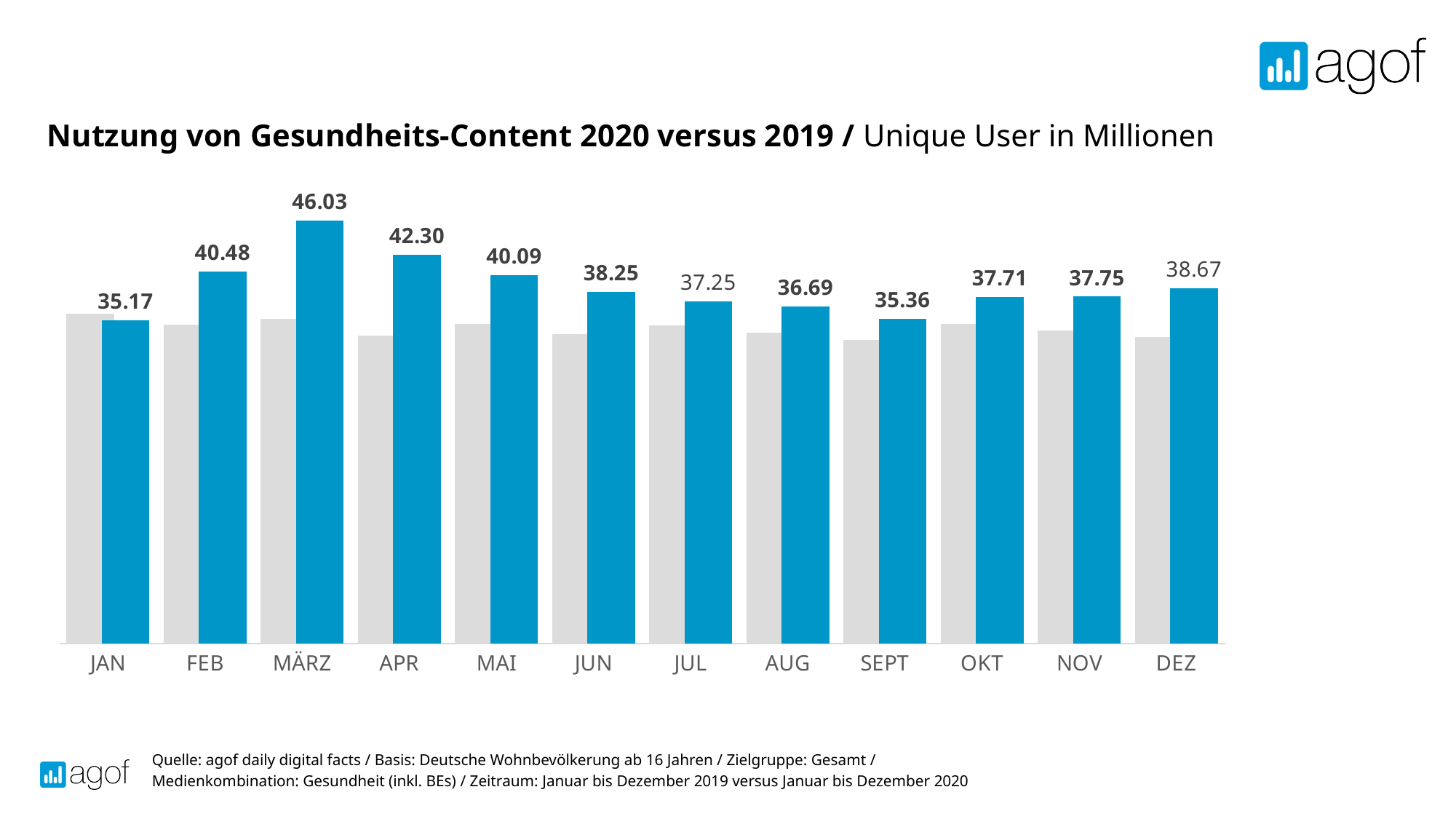
How many months are shown on the x axis? 12 Which has the larger labelled value, JUL or AUG? JUL What is the labelled value for DEZ? 38.67 Which month has the lowest labelled value? JAN Which has the larger labelled value, FEB or APR? APR Which month has the highest labelled value? MÄRZ What is the difference between the labelled values for MÄRZ and JAN? 10.86 What is the labelled value for MÄRZ? 46.03 Do the labelled values rise or fall from MÄRZ to SEPT? Fall What is the labelled value for SEPT? 35.36 What is the difference between the labelled values for APR and MAI? 2.21 What kind of chart is shown on the slide? Bar chart